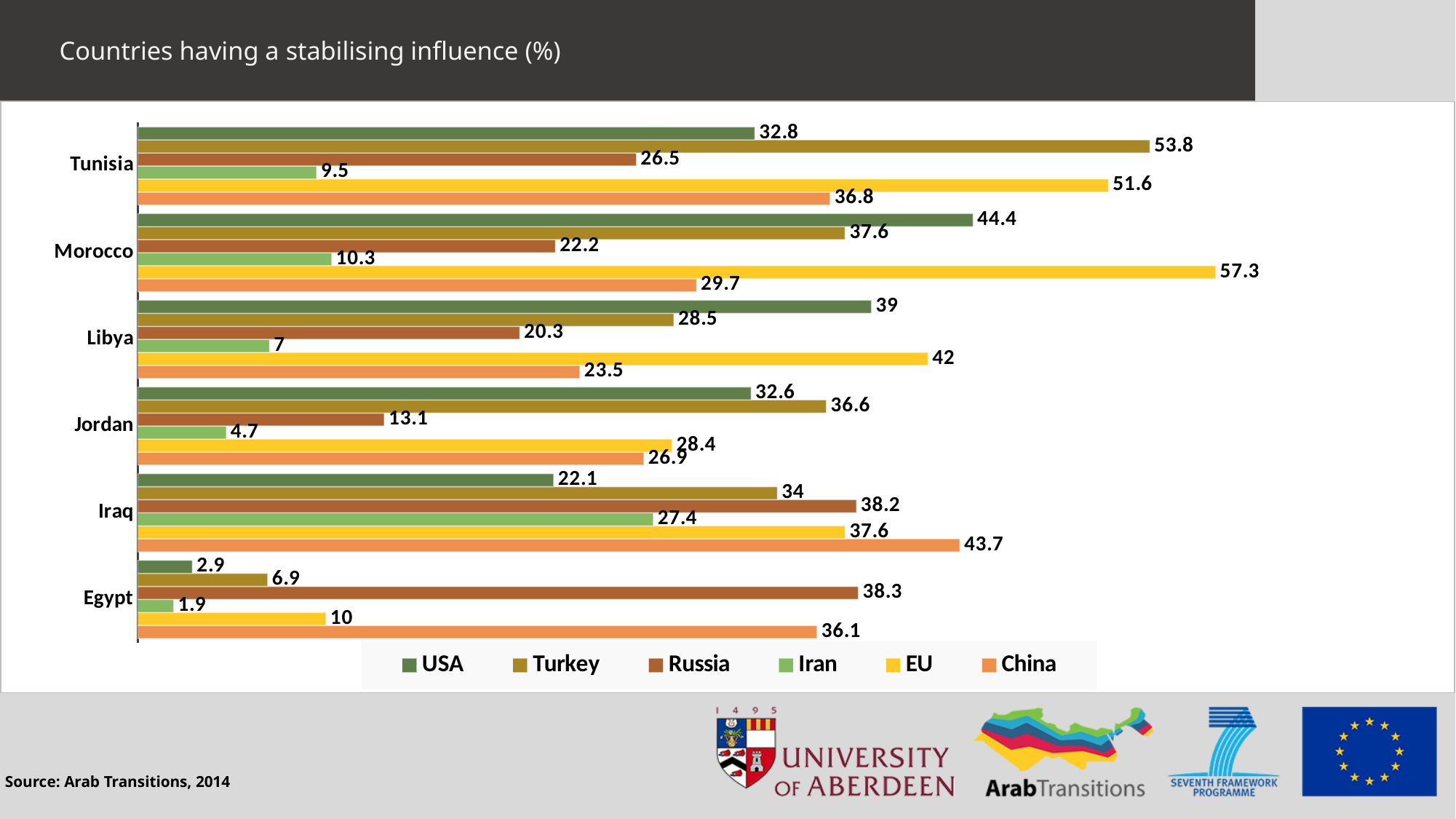
What is the title of the chart? Countries having a stabilising influence (%) What is the difference between the Turkey and USA values for Tunisia? 21 What kind of chart is shown on the slide? Bar chart Which colour represents China in the legend? Orange How many series does the legend list? 6 Which is larger for Libya, the USA value or the EU value? EU What is the value for Russia in Iraq? 38.2 Which series has the highest value for Tunisia? Turkey Which series has the lowest value for Jordan? Iran What is the value for Iran in Egypt? 1.9 How many countries are listed on the vertical axis? 6 What is the value for the EU in Morocco? 57.3